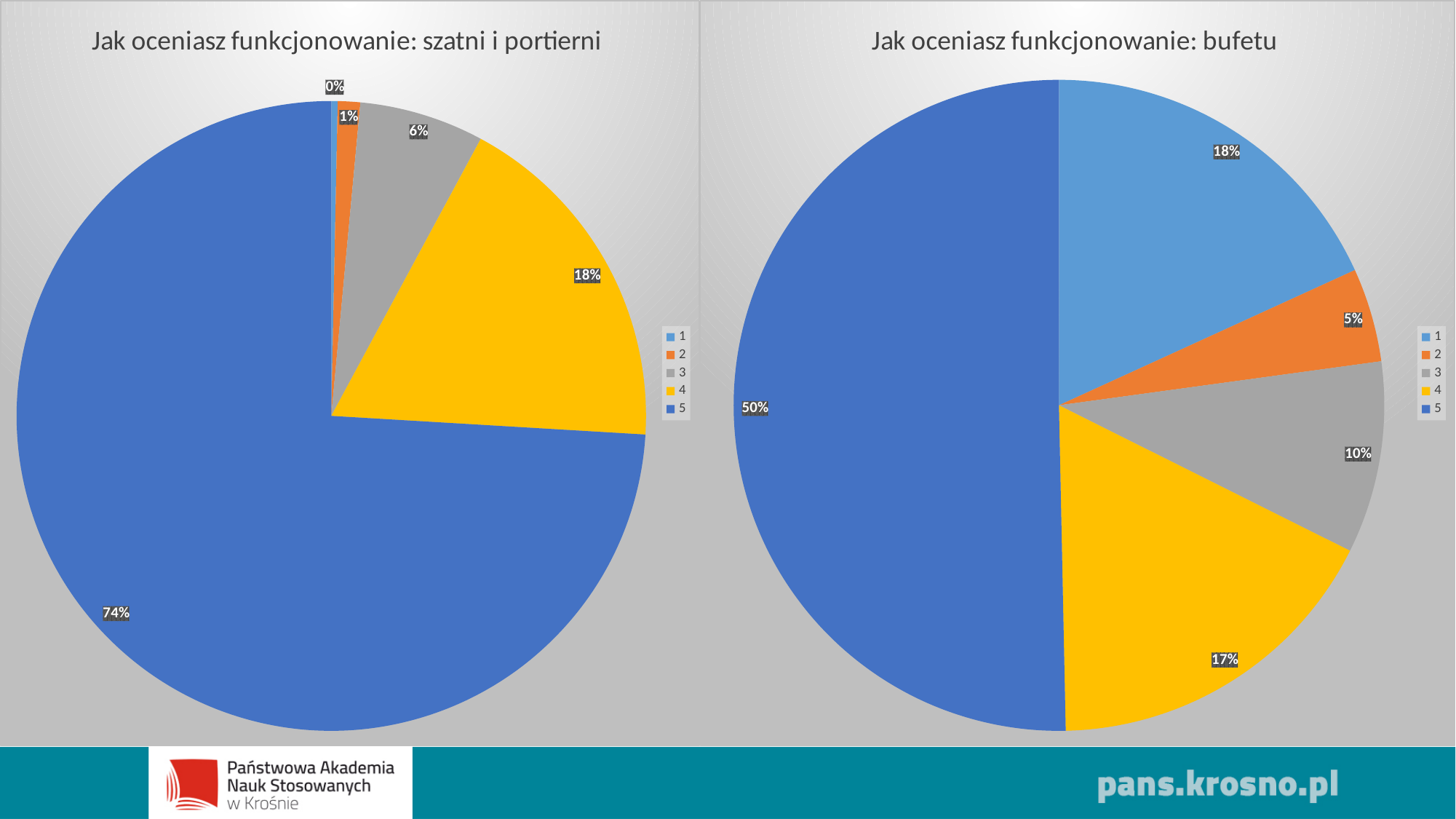
In the chart titled "Jak oceniasz funkcjonowanie: szatni i portierni", what share does category 5 have? 74% In the chart titled "Jak oceniasz funkcjonowanie: szatni i portierni", what share does category 3 have? 6% In the chart titled "Jak oceniasz funkcjonowanie: bufetu", what share does category 1 have? 18% What type of chart is the chart titled "Jak oceniasz funkcjonowanie: szatni i portierni"? pie chart In the chart titled "Jak oceniasz funkcjonowanie: bufetu", which category has the largest slice? 5 In the chart titled "Jak oceniasz funkcjonowanie: bufetu", what is the difference between the shares of category 5 and category 1? 32% In the chart titled "Jak oceniasz funkcjonowanie: bufetu", which category has the smallest slice? 2 In the chart titled "Jak oceniasz funkcjonowanie: szatni i portierni", what share does category 4 have? 18% In the chart titled "Jak oceniasz funkcjonowanie: bufetu", what share does category 4 have? 17% In the chart titled "Jak oceniasz funkcjonowanie: szatni i portierni", which category has the smallest slice? 1 How many entries does the legend of the chart titled "Jak oceniasz funkcjonowanie: bufetu" list? 5 In the chart titled "Jak oceniasz funkcjonowanie: bufetu", which is larger: the share of category 3 or category 2? 3